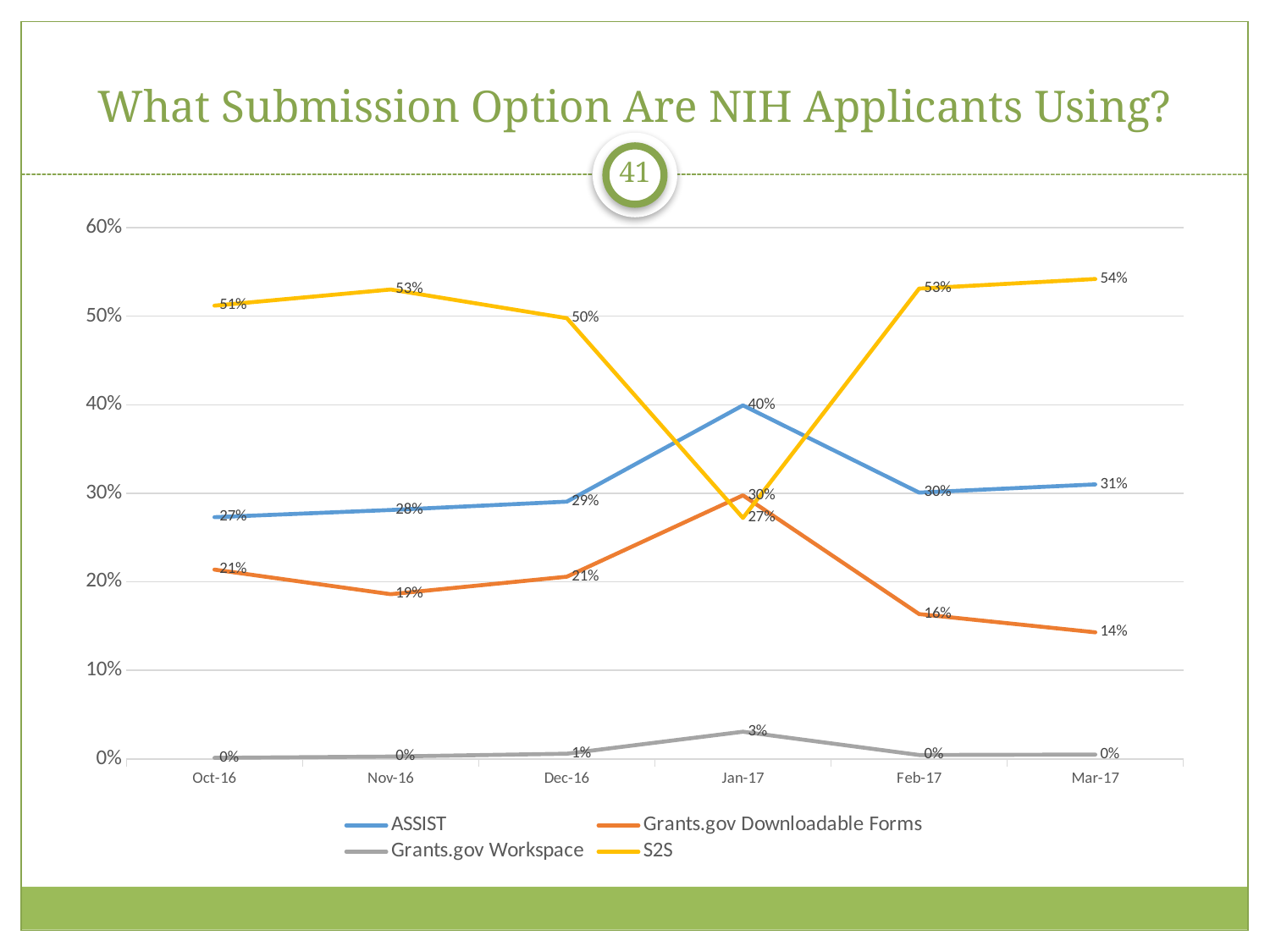
In which month is the ASSIST value highest? Jan-17 What kind of chart is shown on the slide? Line chart How many months are shown on the x axis? 6 How many series does the legend list? 4 What is the value for S2S in Mar-17? 54% Does the Grants.gov Downloadable Forms value rise or fall from Jan-17 to Mar-17? Fall In which month is the S2S value lowest? Jan-17 What is the value for Grants.gov Workspace in Jan-17? 3% Which is larger in Jan-17, the ASSIST value or the S2S value? ASSIST What is the value for Grants.gov Downloadable Forms in Nov-16? 19% What is the value for ASSIST in Jan-17? 40% What is the difference between the S2S value and the ASSIST value in Feb-17? 23%